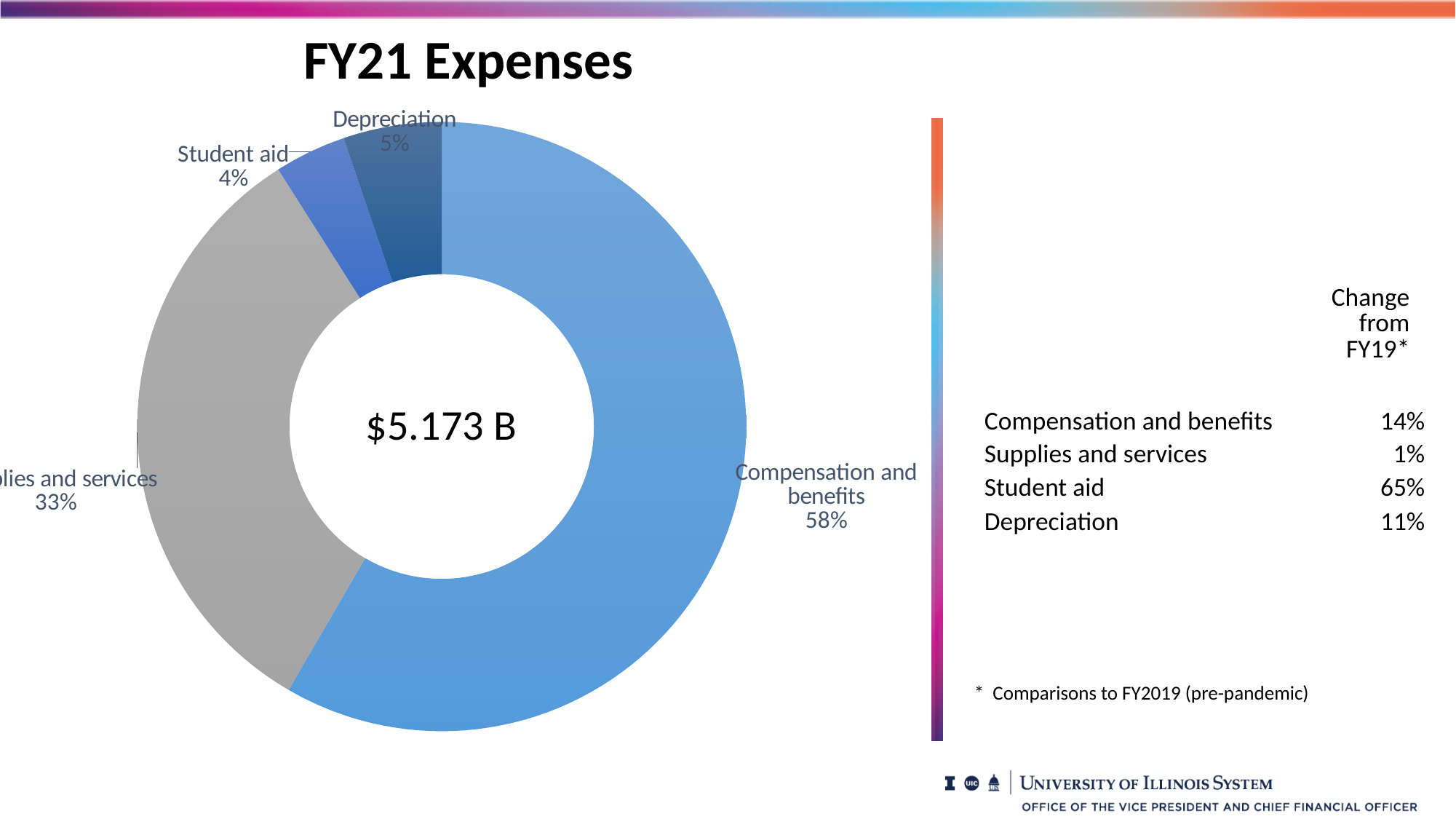
What percentage of the FY21 Expenses chart is Student aid? 4% Which category has the largest share of FY21 expenses? Compensation and benefits What percentage of the FY21 Expenses chart is Depreciation? 5% How many categories are shown in the FY21 Expenses chart? 4 What is the title of the chart on the slide? FY21 Expenses By how many percentage points does Compensation and benefits exceed Supplies and services in the FY21 Expenses chart? 25 What share of FY21 expenses is Compensation and benefits? 58% What kind of chart is shown on the slide? doughnut chart Which category has the smallest share of FY21 expenses? Student aid What percentage of the FY21 Expenses chart is Supplies and services? 33% Which has a larger share of FY21 expenses, Depreciation or Student aid? Depreciation What total amount is shown in the center of the FY21 Expenses chart? $5.173 B